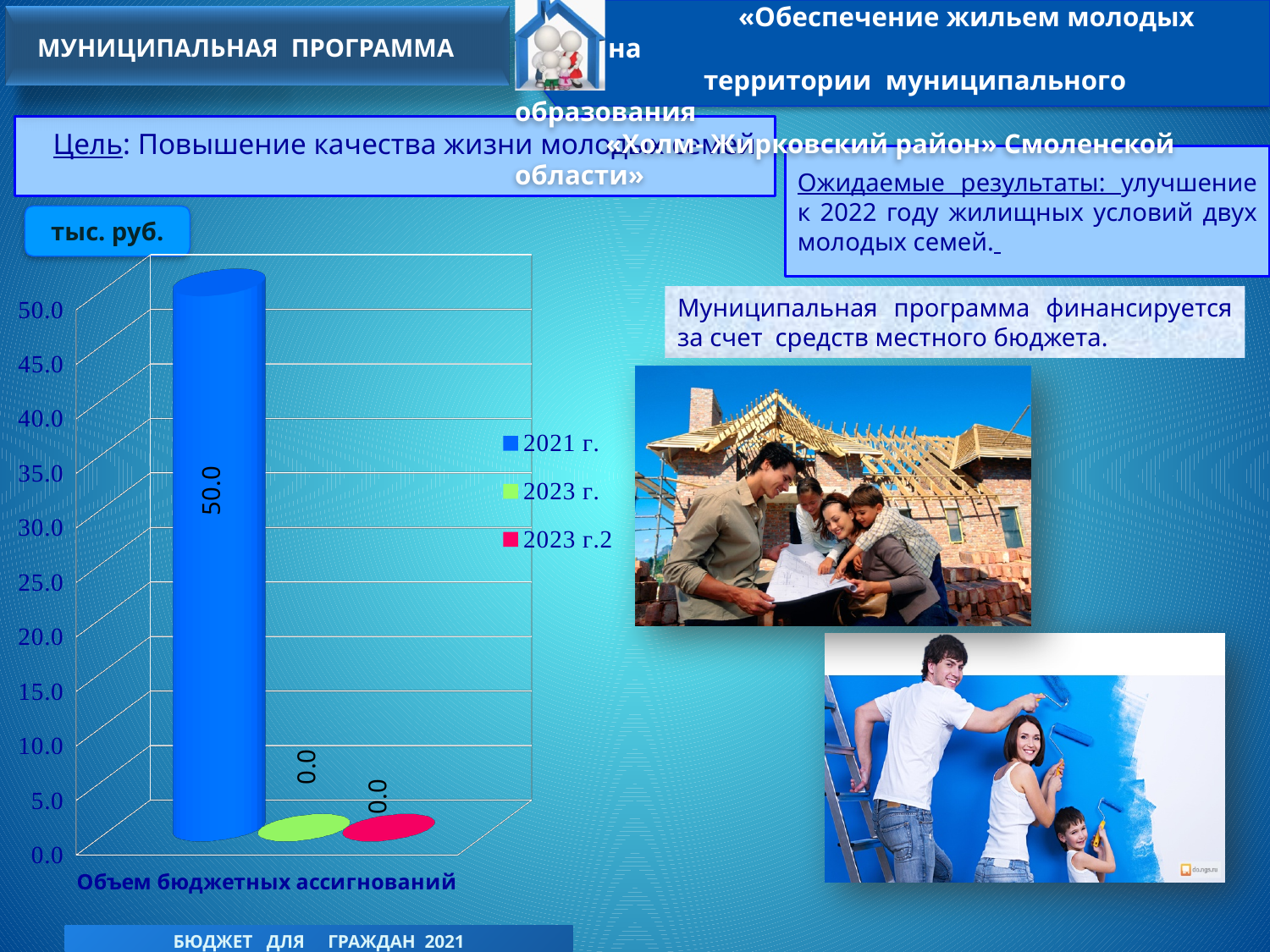
What is the highest tick value shown on the vertical axis of the chart? 50.0 What is the value for the 2023 г. series in the chart? 0.0 What unit is indicated for the chart values? тыс. руб. What is the difference between the 2021 г. value and the 2023 г. value? 50.0 How many series does the legend list? 3 What is the category label shown under the chart? Объем бюджетных ассигнований Which series has the highest value in the chart? 2021 г. Which is larger, the value for 2021 г. or the value for 2023 г.2? 2021 г. What is the value for the 2023 г.2 series in the chart? 0.0 What is the value for the 2021 г. series in the chart? 50.0 What kind of chart is shown on the slide? bar chart Is the value for 2021 г. greater or less than 45.0? greater